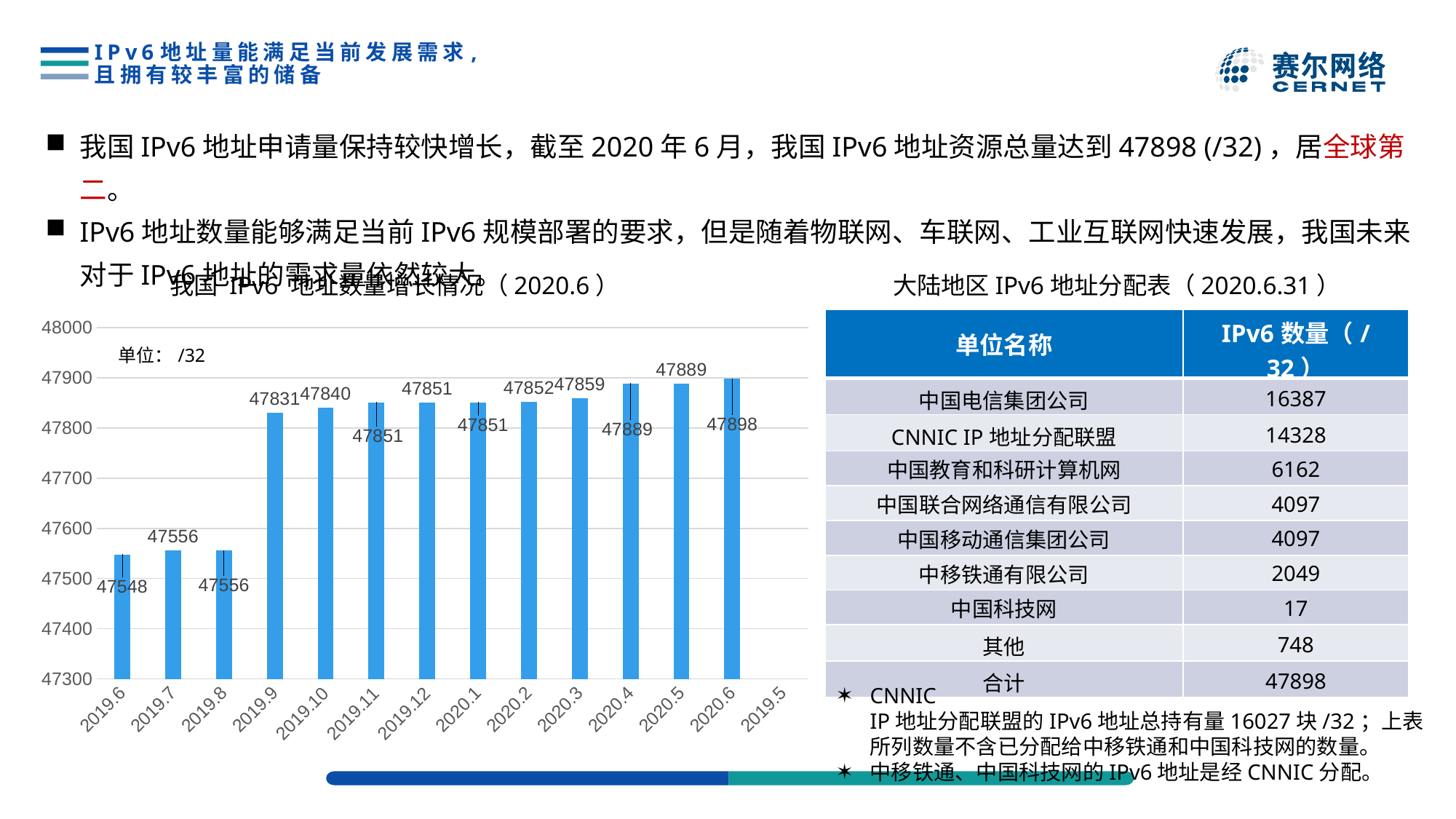
Which period has the lowest value in the bar chart? 2019.6 What is the value for 2019.9 in the bar chart? 47831 Do the values generally rise or fall from 2019.6 to 2020.6? rise Is the value for 2019.9 greater or less than 47800? greater What is the value for 2020.6 in the bar chart? 47898 What is the difference between the values for 2020.6 and 2019.6? 350 Which period has the highest value in the bar chart? 2020.6 What is the value for 2020.3 in the bar chart? 47859 What is the difference between the values for 2019.9 and 2019.8? 275 Which is larger, the value for 2020.4 or the value for 2019.10? 2020.4 What is the value for 2019.6 in the bar chart? 47548 What kind of chart is shown on the slide? bar chart